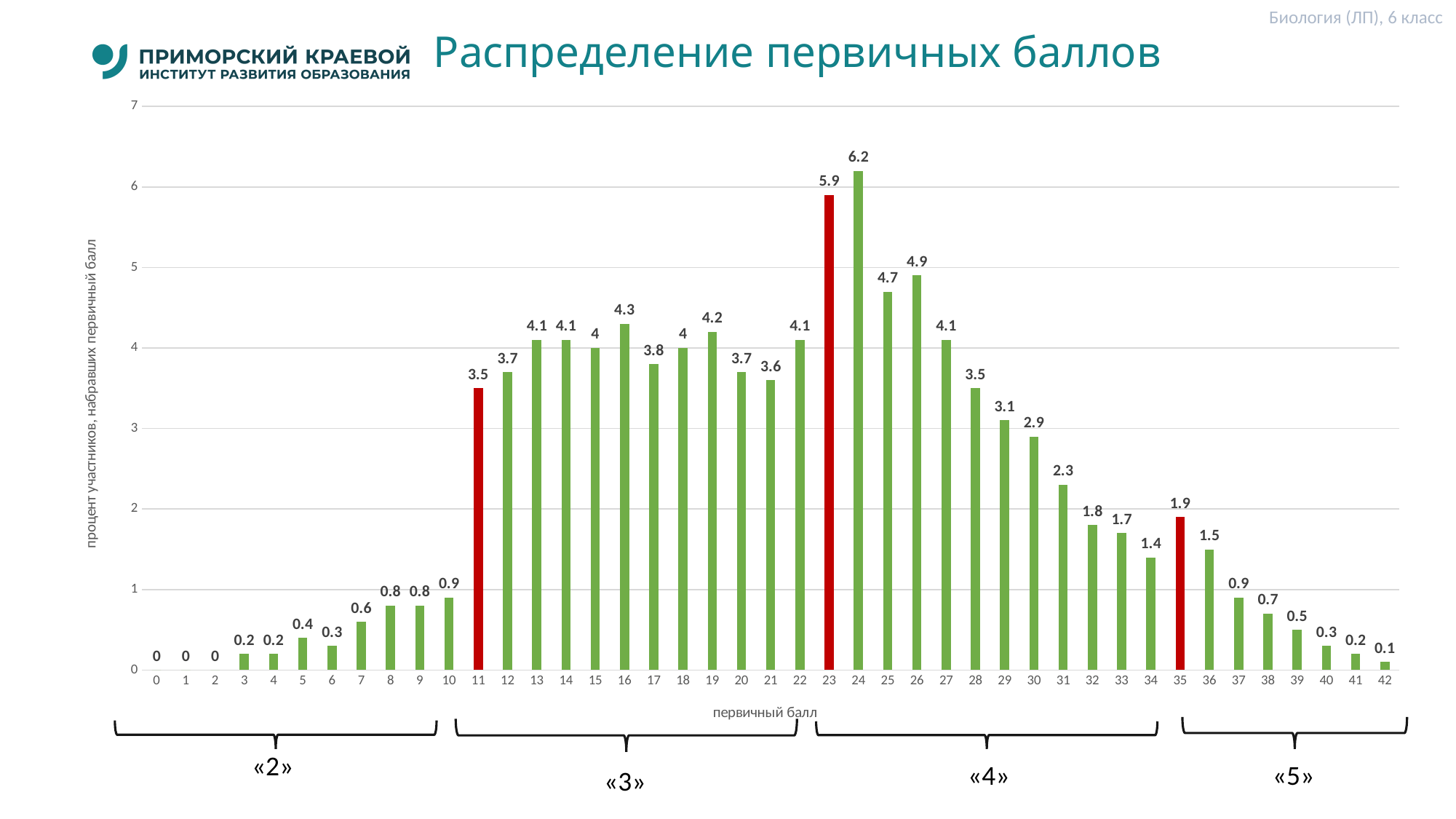
How many первичный балл categories are shown on the x axis? 43 What type of chart is shown on the slide? bar chart What is the lowest value shown on the chart? 0 What is the value for первичный балл 24? 6.2 What is the value for первичный балл 11? 3.5 Do the values rise or fall from первичный балл 24 to первичный балл 34? fall What is the title of the chart? Распределение первичных баллов Which первичный балл has the highest value? 24 Which has a larger value, первичный балл 26 or первичный балл 25? 26 What is the difference between the values for первичный балл 24 and первичный балл 23? 0.3 Which первичный балл values are shown with red bars? 11, 23, 35 What is the value for первичный балл 35? 1.9